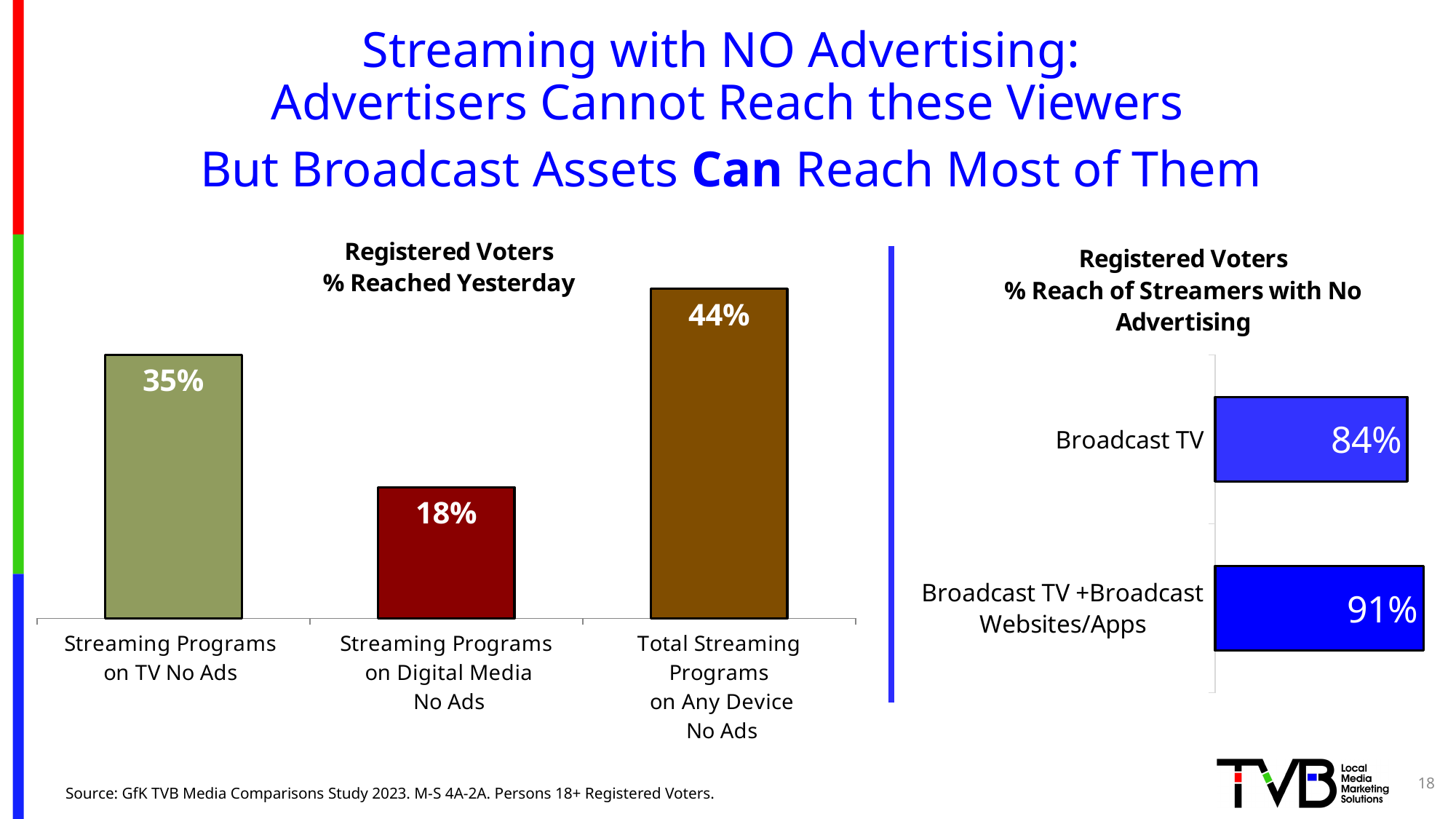
In the left chart (Registered Voters % Reached Yesterday), what is the value for Streaming Programs on Digital Media No Ads? 18% In the right chart (% Reach of Streamers with No Advertising), what is the value for Broadcast TV? 84% In the left chart (Registered Voters % Reached Yesterday), how many categories are shown? 3 In the left chart (Registered Voters % Reached Yesterday), what is the value for Total Streaming Programs on Any Device No Ads? 44% In the right chart (% Reach of Streamers with No Advertising), which is larger: Broadcast TV or Broadcast TV + Broadcast Websites/Apps? Broadcast TV + Broadcast Websites/Apps In the left chart (Registered Voters % Reached Yesterday), what is the value for Streaming Programs on TV No Ads? 35% In the left chart (Registered Voters % Reached Yesterday), what is the difference between Streaming Programs on TV No Ads and Streaming Programs on Digital Media No Ads? 17% In the right chart (% Reach of Streamers with No Advertising), what is the difference between Broadcast TV + Broadcast Websites/Apps and Broadcast TV? 7% In the left chart (Registered Voters % Reached Yesterday), which category has the lowest value? Streaming Programs on Digital Media No Ads In the right chart (% Reach of Streamers with No Advertising), what is the value for Broadcast TV + Broadcast Websites/Apps? 91% What type of chart is the right chart (% Reach of Streamers with No Advertising)? Bar chart In the left chart (Registered Voters % Reached Yesterday), which category has the highest value? Total Streaming Programs on Any Device No Ads